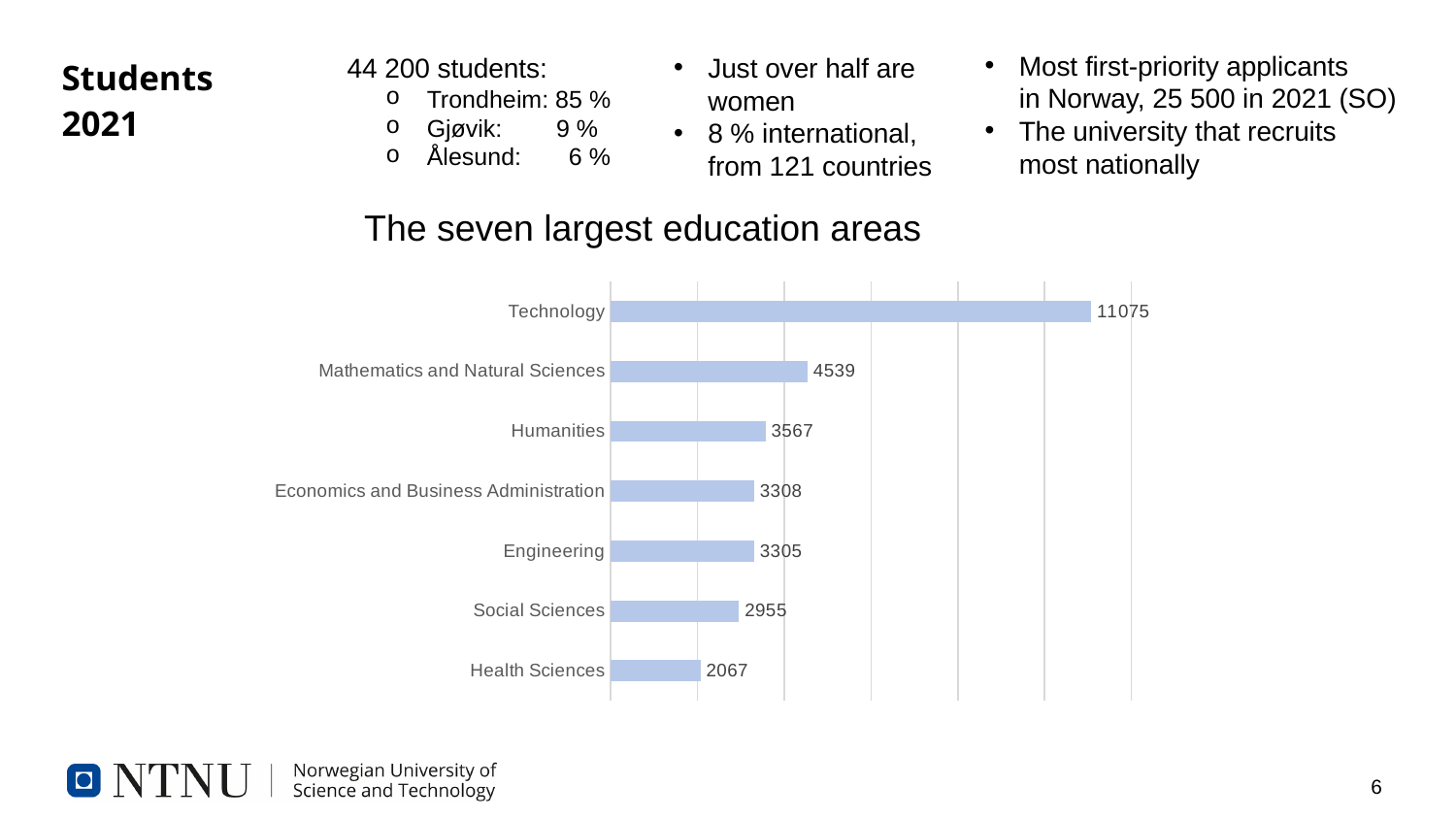
What is the value for Technology? 11075 What kind of chart is shown on the slide? bar chart Which education area has the highest value? Technology What is the value for Social Sciences? 2955 Which is larger, the value for Humanities or the value for Social Sciences? Humanities What is the title of the chart? The seven largest education areas How many education areas are shown in the chart? 7 What is the value for Health Sciences? 2067 What is the difference between the values for Technology and Mathematics and Natural Sciences? 6536 Which education area has the lowest value? Health Sciences What is the difference between the values for Economics and Business Administration and Engineering? 3 What is the value for Mathematics and Natural Sciences? 4539